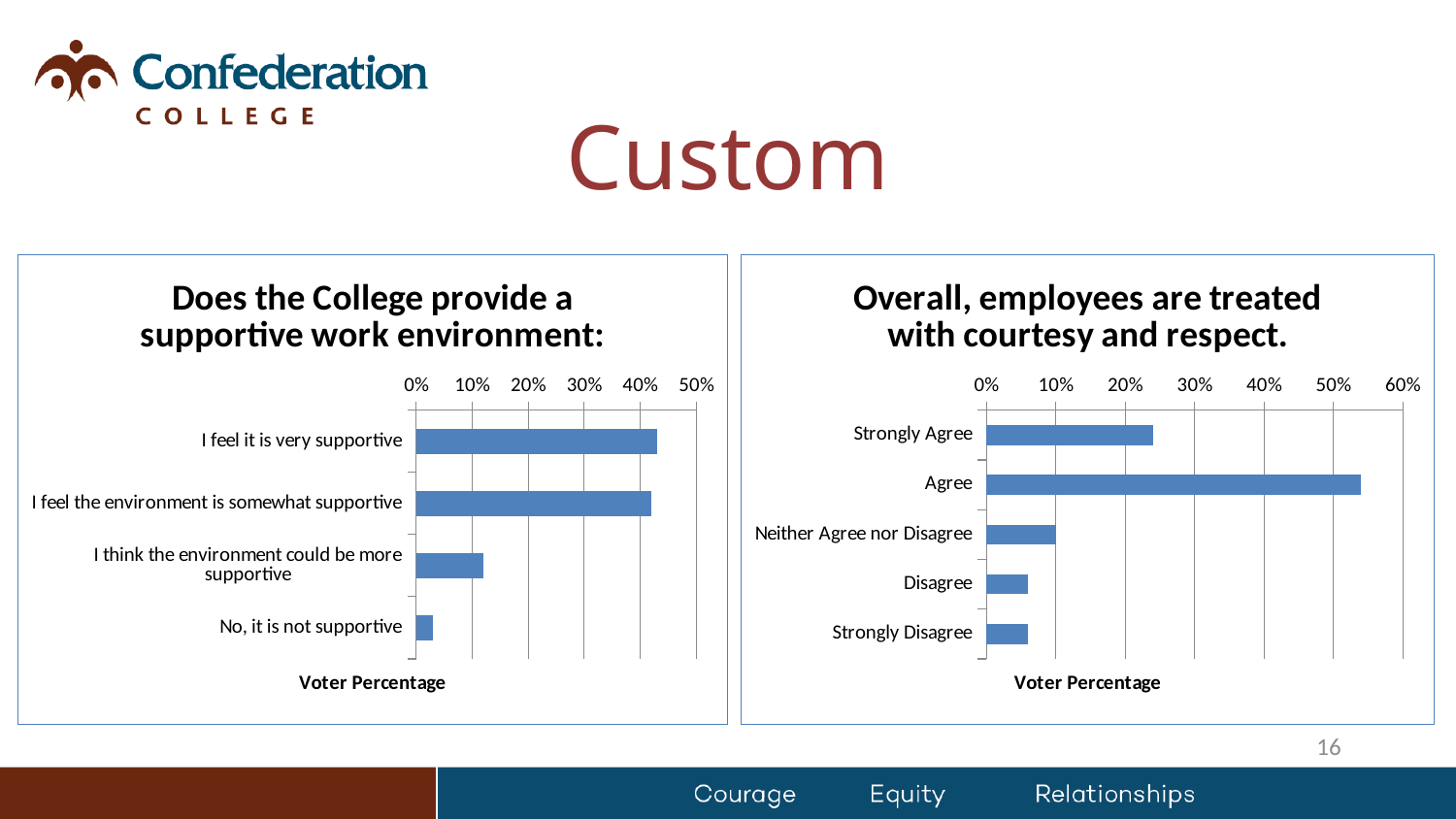
In the chart titled "Does the College provide a supportive work environment:", is the value for "I feel it is very supportive" greater or less than 40%? greater How many categories are shown in the chart titled "Does the College provide a supportive work environment:"? 4 In the chart titled "Overall, employees are treated with courtesy and respect.", is the value for "Agree" greater or less than 50%? greater In the chart titled "Overall, employees are treated with courtesy and respect.", which category has the highest value? Agree In the chart titled "Overall, employees are treated with courtesy and respect.", which is larger: the value for "Strongly Agree" or the value for "Neither Agree nor Disagree"? Strongly Agree What kind of chart is the chart titled "Does the College provide a supportive work environment:"? bar chart How many categories are shown in the chart titled "Overall, employees are treated with courtesy and respect."? 5 In the chart titled "Does the College provide a supportive work environment:", which category has the lowest value? No, it is not supportive In the chart titled "Overall, employees are treated with courtesy and respect.", is the value for "Strongly Agree" greater or less than 20%? greater What is the x-axis title of the chart titled "Overall, employees are treated with courtesy and respect."? Voter Percentage In the chart titled "Does the College provide a supportive work environment:", which is larger: the value for "I think the environment could be more supportive" or the value for "No, it is not supportive"? I think the environment could be more supportive